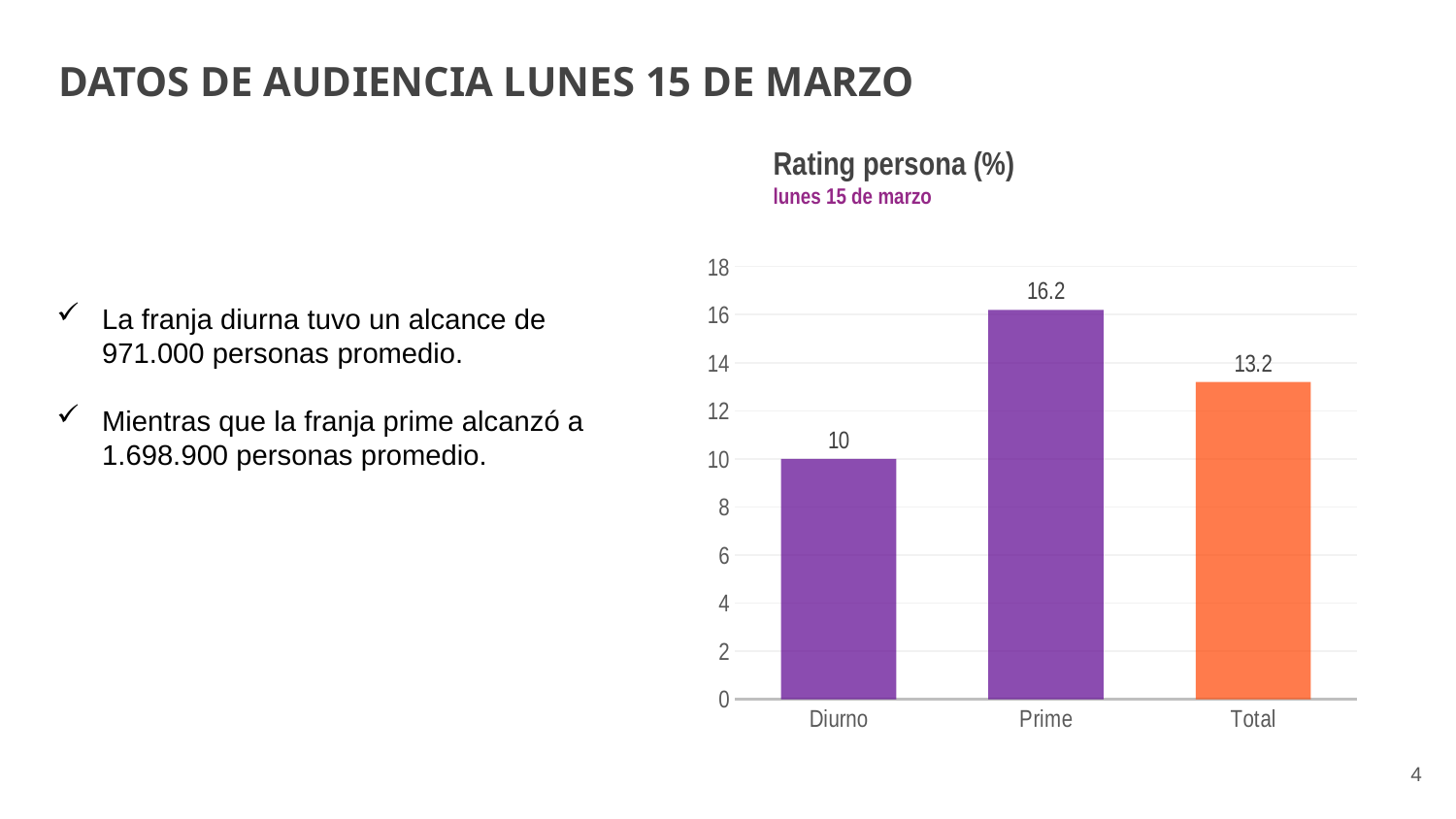
Which is larger, the value for Total or the value for Diurno? Total What is the value for Diurno? 10 Is the value for Prime greater or less than 14? greater What is the value for Prime? 16.2 What is the difference between the values for Prime and Total? 3 How many categories are shown on the x axis? 3 Which category has the lowest value? Diurno What is the value for Total? 13.2 Which category has the highest value? Prime What is the title of the chart? Rating persona (%) What kind of chart is shown on the slide? bar chart What is the difference between the values for Prime and Diurno? 6.2